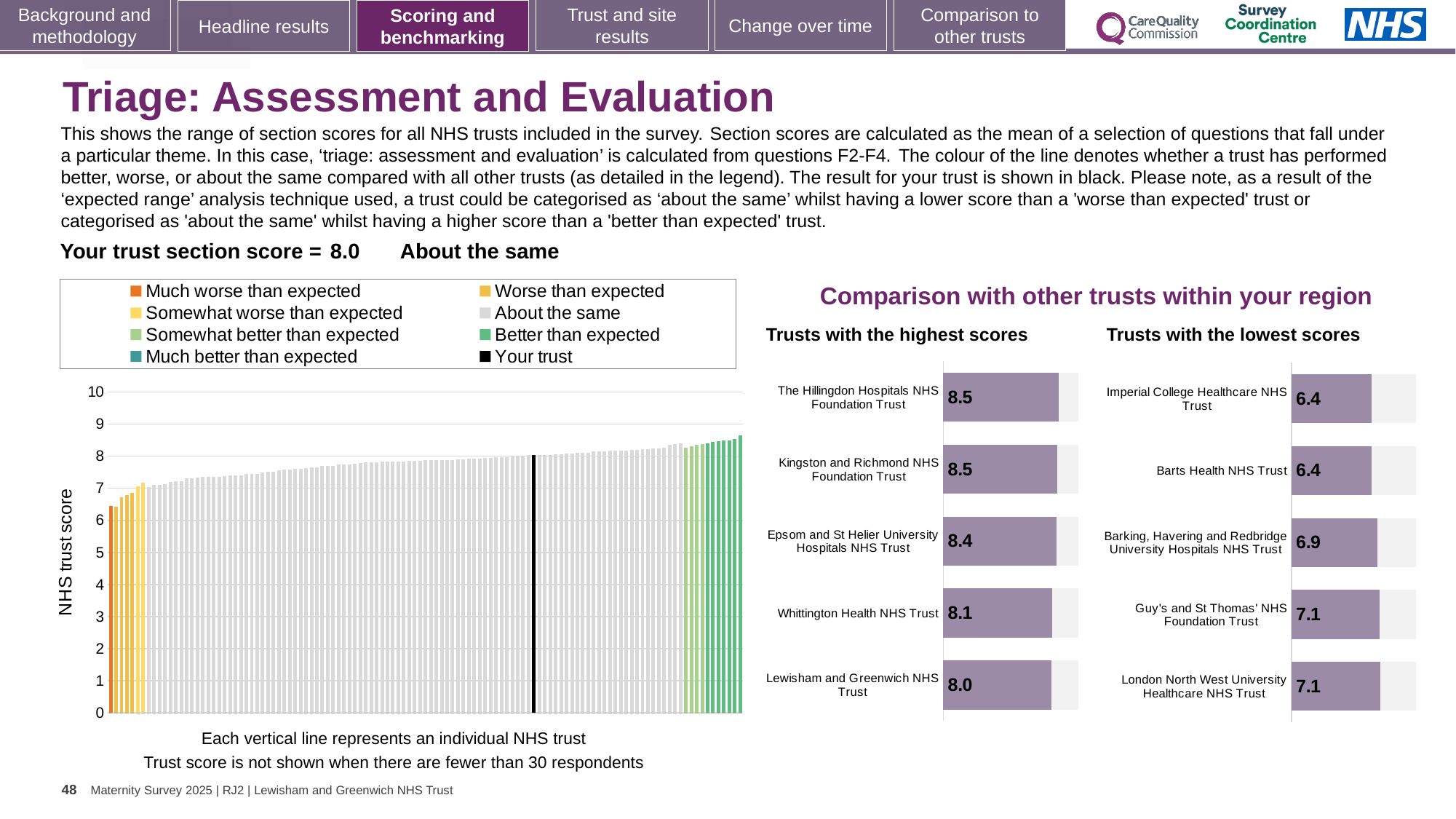
In the 'Trusts with the highest scores' chart, what is the difference between the scores of The Hillingdon Hospitals NHS Foundation Trust and Lewisham and Greenwich NHS Trust? 0.5 How many entries does the legend of the large 'NHS trust score' chart list? 8 In the 'Trusts with the lowest scores' chart, what is the score for Barking, Havering and Redbridge University Hospitals NHS Trust? 6.9 How many trusts are shown in the 'Trusts with the lowest scores' chart? 5 In the 'Trusts with the lowest scores' chart, what is the score for Imperial College Healthcare NHS Trust? 6.4 In the 'Trusts with the lowest scores' chart, which has the higher score: Barts Health NHS Trust or Barking, Havering and Redbridge University Hospitals NHS Trust? Barking, Havering and Redbridge University Hospitals NHS Trust In the 'Trusts with the highest scores' chart, which trust has the lowest score? Lewisham and Greenwich NHS Trust What kind of chart is the large chart on the left with the y-axis labelled 'NHS trust score'? Bar chart In the 'Trusts with the highest scores' chart, what is the score for The Hillingdon Hospitals NHS Foundation Trust? 8.5 In the large 'NHS trust score' chart on the left, do the bar values rise or fall from left to right? Rise In the large 'NHS trust score' chart on the left, is the value of the black bar (your trust) greater or less than 5? greater In the 'Trusts with the highest scores' chart, what is the score for Whittington Health NHS Trust? 8.1